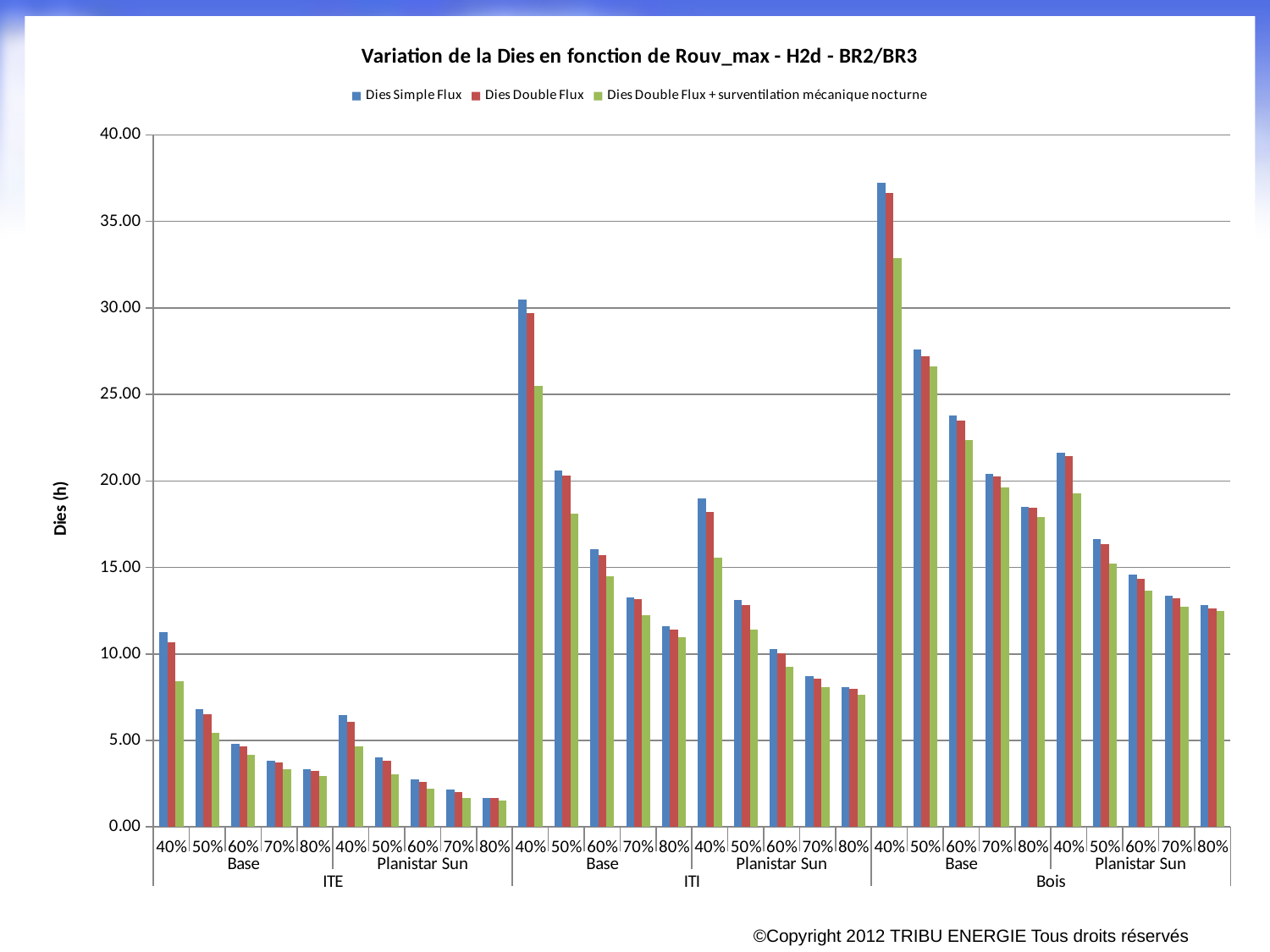
Is the Dies Simple Flux value for Bois, Planistar Sun, 80% greater or less than 15.00? less How many series does the legend list? 3 Which wall type (ITE, ITI or Bois) has the lowest bars overall? ITE Is the Dies Simple Flux value for Bois, Base, 40% greater or less than 35.00? greater What is the title of the chart? Variation de la Dies en fonction de Rouv_max - H2d - BR2/BR3 What kind of chart is shown on the slide? bar chart Which wall type (ITE, ITI or Bois) contains the tallest bar on the chart? Bois Is the Dies Simple Flux value for ITE, Base, 40% greater or less than 10.00? greater Which is larger: the Dies Simple Flux value for ITE, Base, 40% or for ITI, Base, 40%? ITI, Base, 40% Within each glazing group, do the values rise or fall as Rouv_max increases from 40% to 80%? fall What is the label of the vertical axis? Dies (h)